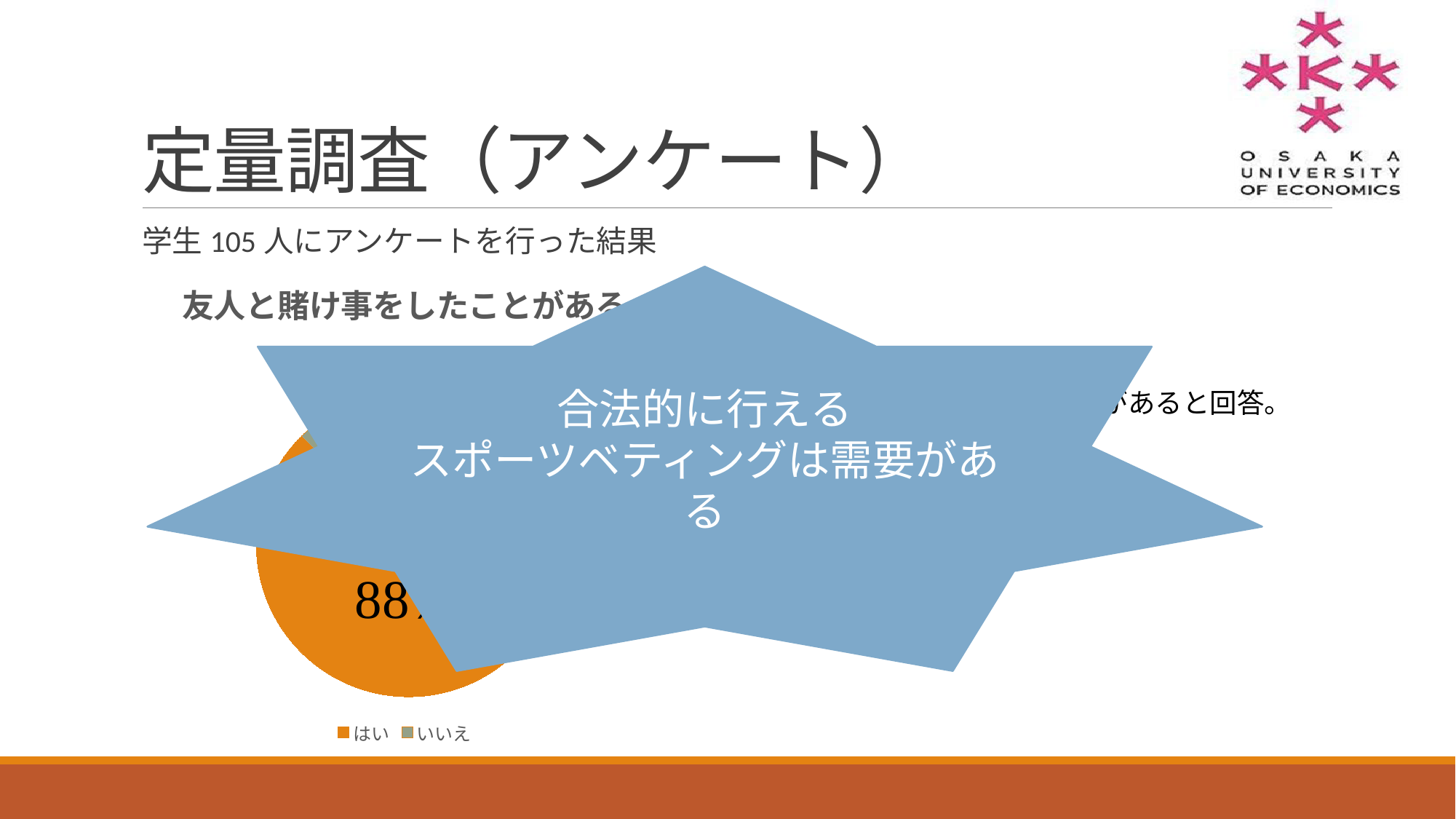
Which category has the largest slice in the pie chart? はい How many entries does the legend of the pie chart list? 2 What are the two legend entries of the pie chart? はい, いいえ What colour is the はい slice in the pie chart? orange Which slice is larger in the pie chart, はい or いいえ? はい Which category has the smallest slice in the pie chart? いいえ How many categories does the pie chart have according to its legend? 2 What kind of chart is shown on the slide? pie chart